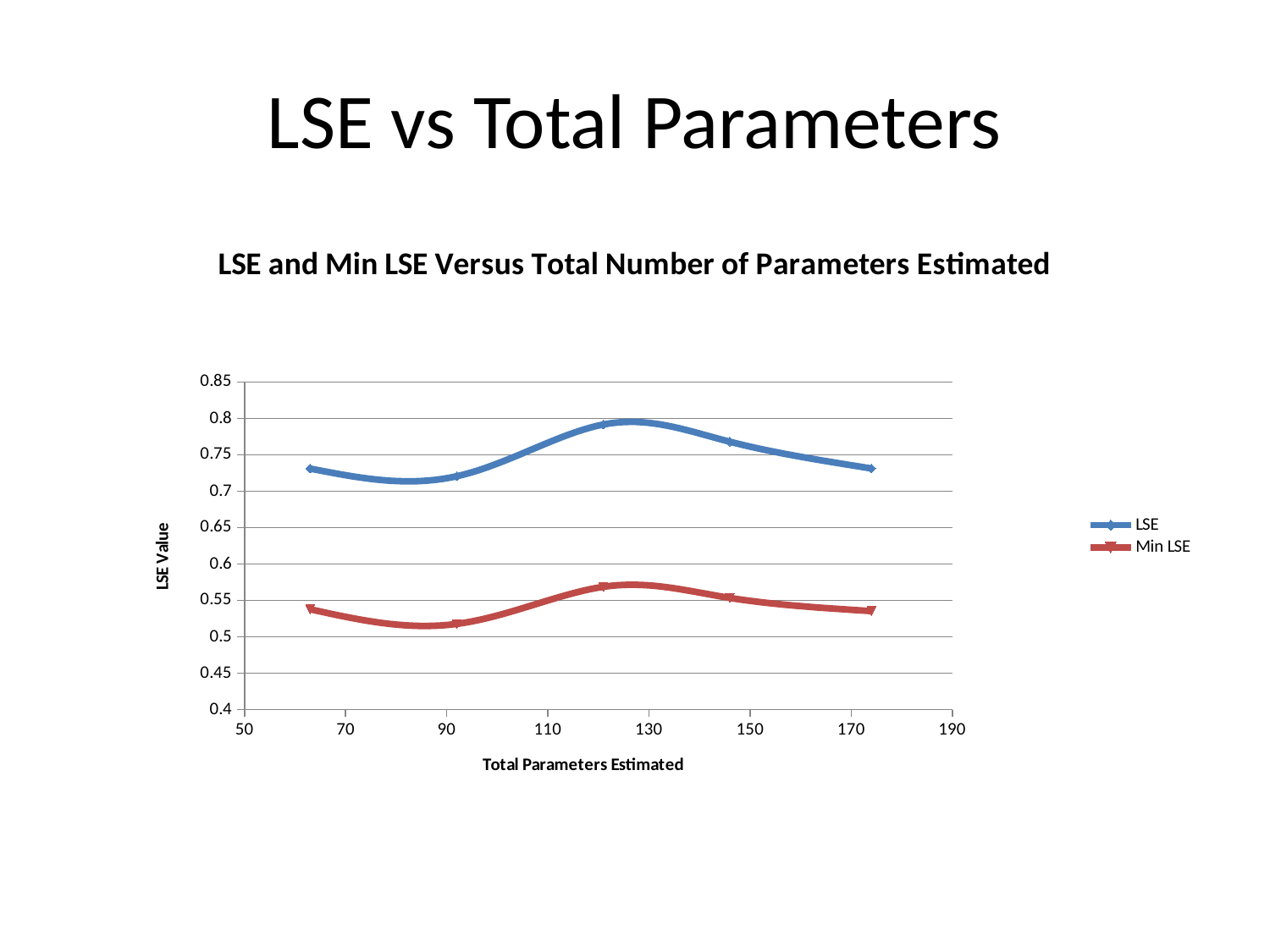
Is the value of the LSE series at its first data point (near 63 parameters) greater or less than 0.7? greater How many data points are plotted for the LSE series? 5 Is the peak value of the Min LSE series (near 120 parameters) greater or less than 0.55? greater Is the peak value of the LSE series (near 120 parameters) greater or less than 0.75? greater What are the two series named in the legend? LSE and Min LSE Does the LSE series rise or fall between its second data point (near 92 parameters) and its third data point (near 120 parameters)? rise What kind of chart is shown on the slide? line chart Which series has the higher values across the whole chart, LSE or Min LSE? LSE What is the title of the chart? LSE and Min LSE Versus Total Number of Parameters Estimated How many series does the legend list? 2 Does the Min LSE series rise or fall between its third data point (near 120 parameters) and its last data point (near 174 parameters)? fall